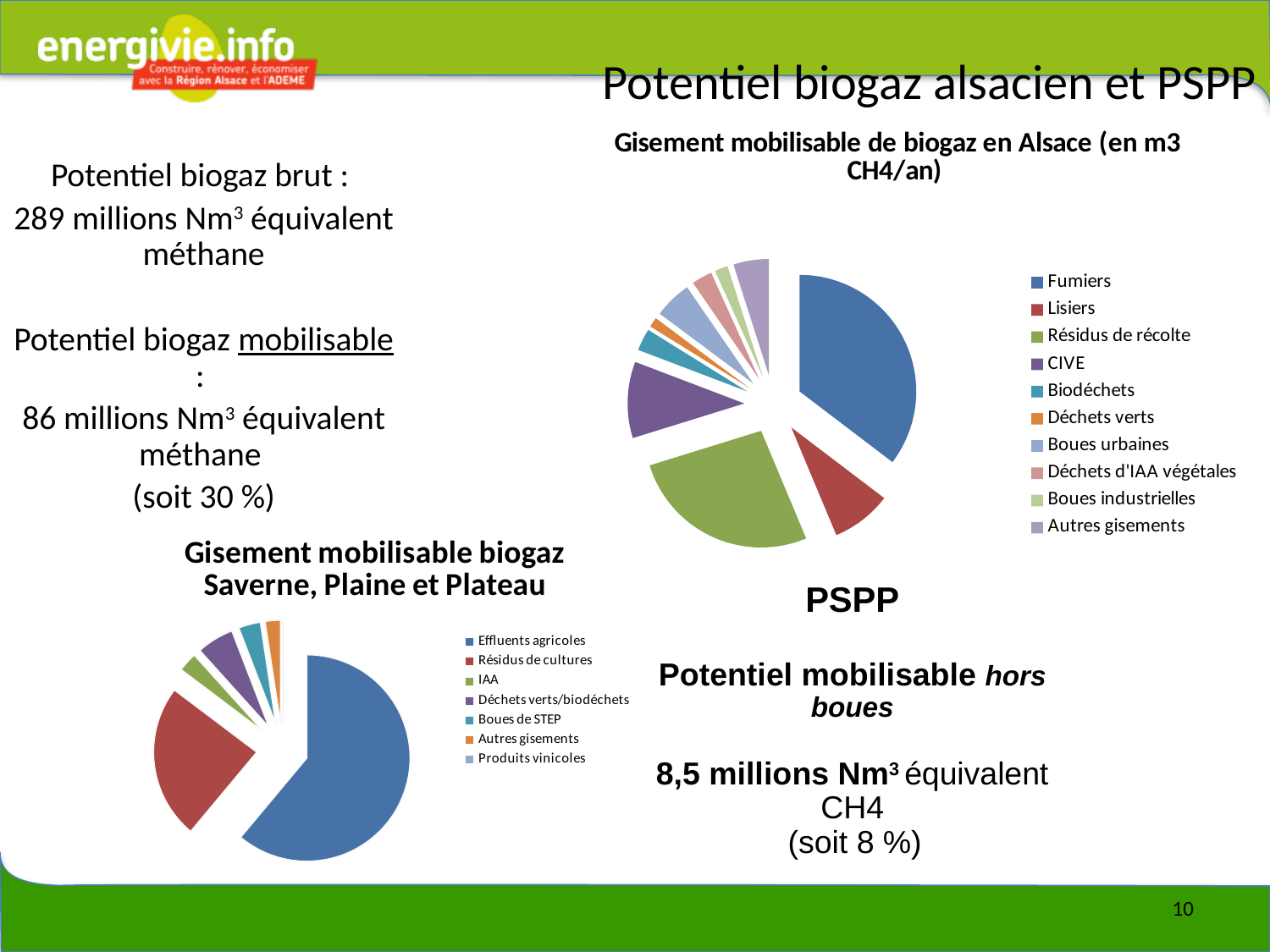
How many categories does the legend of the chart "Gisement mobilisable de biogaz en Alsace (en m3 CH4/an)" list? 10 What kind of chart is the chart titled "Gisement mobilisable biogaz Saverne, Plaine et Plateau"? Pie chart In the chart "Gisement mobilisable biogaz Saverne, Plaine et Plateau", which colour represents Effluents agricoles? Blue In the chart "Gisement mobilisable biogaz Saverne, Plaine et Plateau", which slice is larger: Résidus de cultures or Boues de STEP? Résidus de cultures In the chart "Gisement mobilisable biogaz Saverne, Plaine et Plateau", which category has the largest slice? Effluents agricoles What kind of chart is the chart titled "Gisement mobilisable de biogaz en Alsace (en m3 CH4/an)"? Pie chart In the chart "Gisement mobilisable biogaz Saverne, Plaine et Plateau", which slice is larger: Effluents agricoles or Résidus de cultures? Effluents agricoles In the chart "Gisement mobilisable de biogaz en Alsace (en m3 CH4/an)", which category has the largest slice? Fumiers In the chart "Gisement mobilisable de biogaz en Alsace (en m3 CH4/an)", which slice is larger: Fumiers or Lisiers? Fumiers How many categories does the legend of the chart "Gisement mobilisable biogaz Saverne, Plaine et Plateau" list? 7 What is the title of the pie chart in the upper right of the slide? Gisement mobilisable de biogaz en Alsace (en m3 CH4/an)